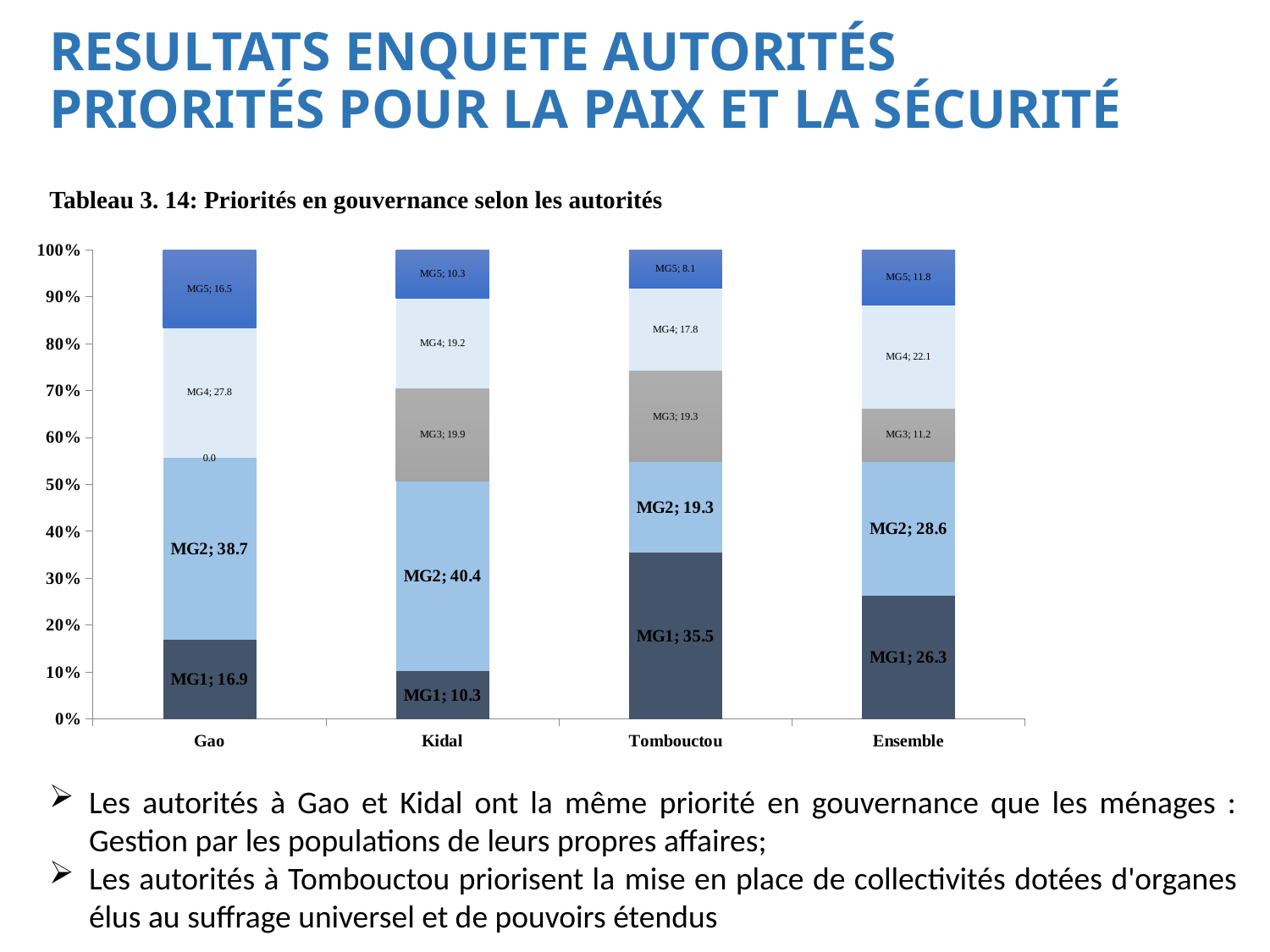
What is the value for MG1 in Tombouctou? 35.5 What is the value for MG5 in Ensemble? 11.8 What is the value for MG4 in Gao? 27.8 What is the value for MG3 in Gao? 0.0 Which category has the highest value for MG1? Tombouctou What is the title of the chart? Tableau 3. 14: Priorités en gouvernance selon les autorités What is the difference between the MG2 values for Gao and Tombouctou? 19.4 Which is larger, the MG1 value for Ensemble or the MG1 value for Kidal? Ensemble What kind of chart is shown on the slide? Stacked bar chart What is the value for MG2 in Kidal? 40.4 How many categories are shown on the x axis? 4 Which category has the lowest value for MG5? Tombouctou